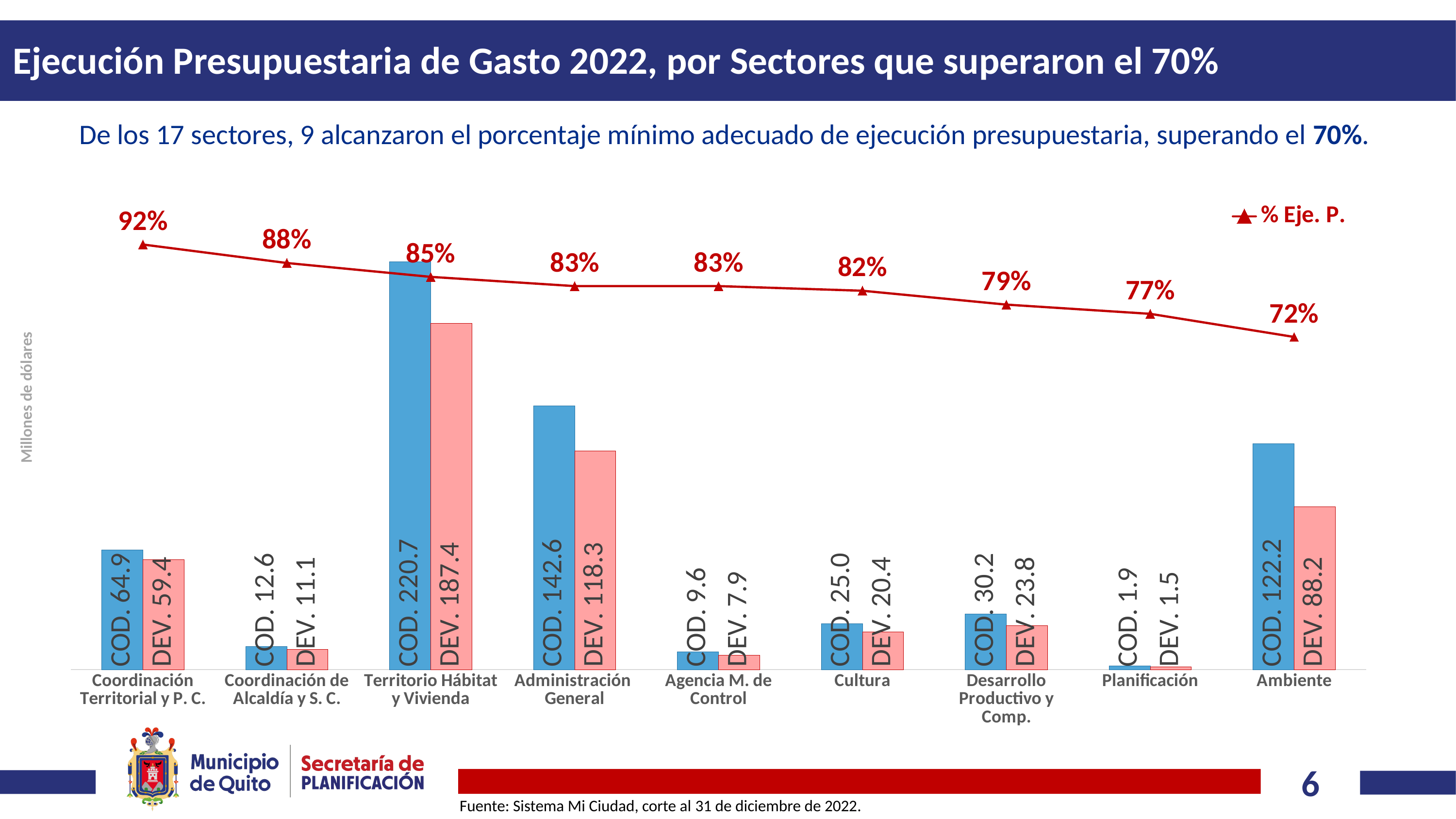
What is the COD. value for Territorio Hábitat y Vivienda? 220.7 What is the % Eje. P. value for Cultura? 82% What is the unit label on the vertical axis of the chart? Millones de dólares What is the DEV. value for Planificación? 1.5 What is the DEV. value for Ambiente? 88.2 Which sector has the lowest % Eje. P. value? Ambiente Do the % Eje. P. values rise or fall from left to right along the x axis? fall What is the difference between the COD. and DEV. values for Territorio Hábitat y Vivienda? 33.3 Which sector has the highest % Eje. P. value? Coordinación Territorial y P. C. Which sector has the highest COD. value? Territorio Hábitat y Vivienda Which is larger, the COD. value for Cultura or the COD. value for Desarrollo Productivo y Comp.? Desarrollo Productivo y Comp. How many sectors are shown on the x axis of the chart? 9